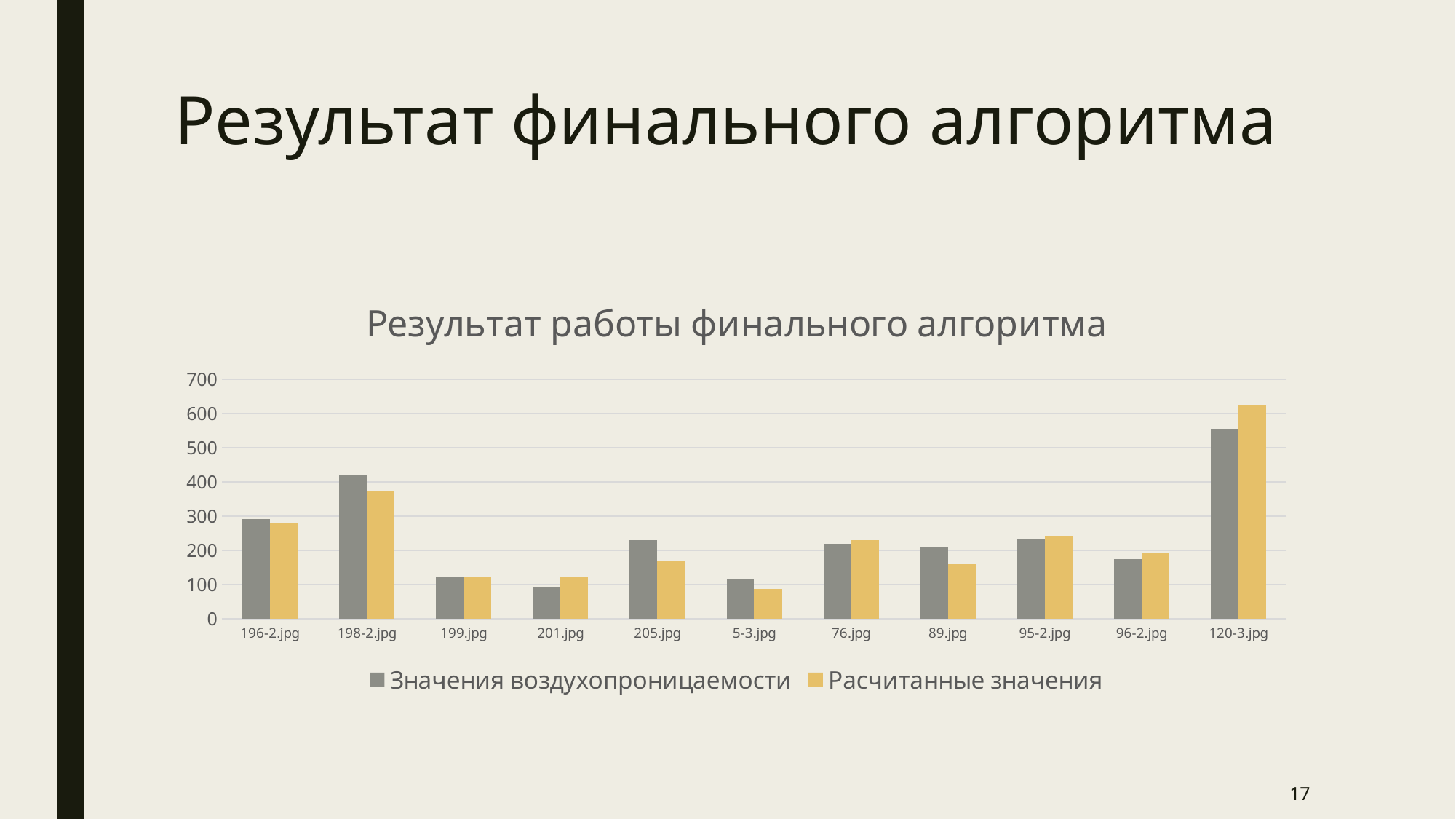
Is the value of Расчитанные значения for 120-3.jpg greater or less than 600? greater Which category has the highest value for Значения воздухопроницаемости? 120-3.jpg Is the value of Значения воздухопроницаемости for 198-2.jpg greater or less than 400? greater Which category has the lowest value for Значения воздухопроницаемости? 201.jpg How many series does the legend list? 2 Is the value of Расчитанные значения for 205.jpg greater or less than 200? less What is the title of the chart? Результат работы финального алгоритма For 89.jpg, which series has the larger value: Значения воздухопроницаемости or Расчитанные значения? Значения воздухопроницаемости For 201.jpg, which series has the larger value: Значения воздухопроницаемости or Расчитанные значения? Расчитанные значения What kind of chart is shown on the slide? bar chart Which category has the lowest value for Расчитанные значения? 5-3.jpg How many image categories are shown on the x axis? 11